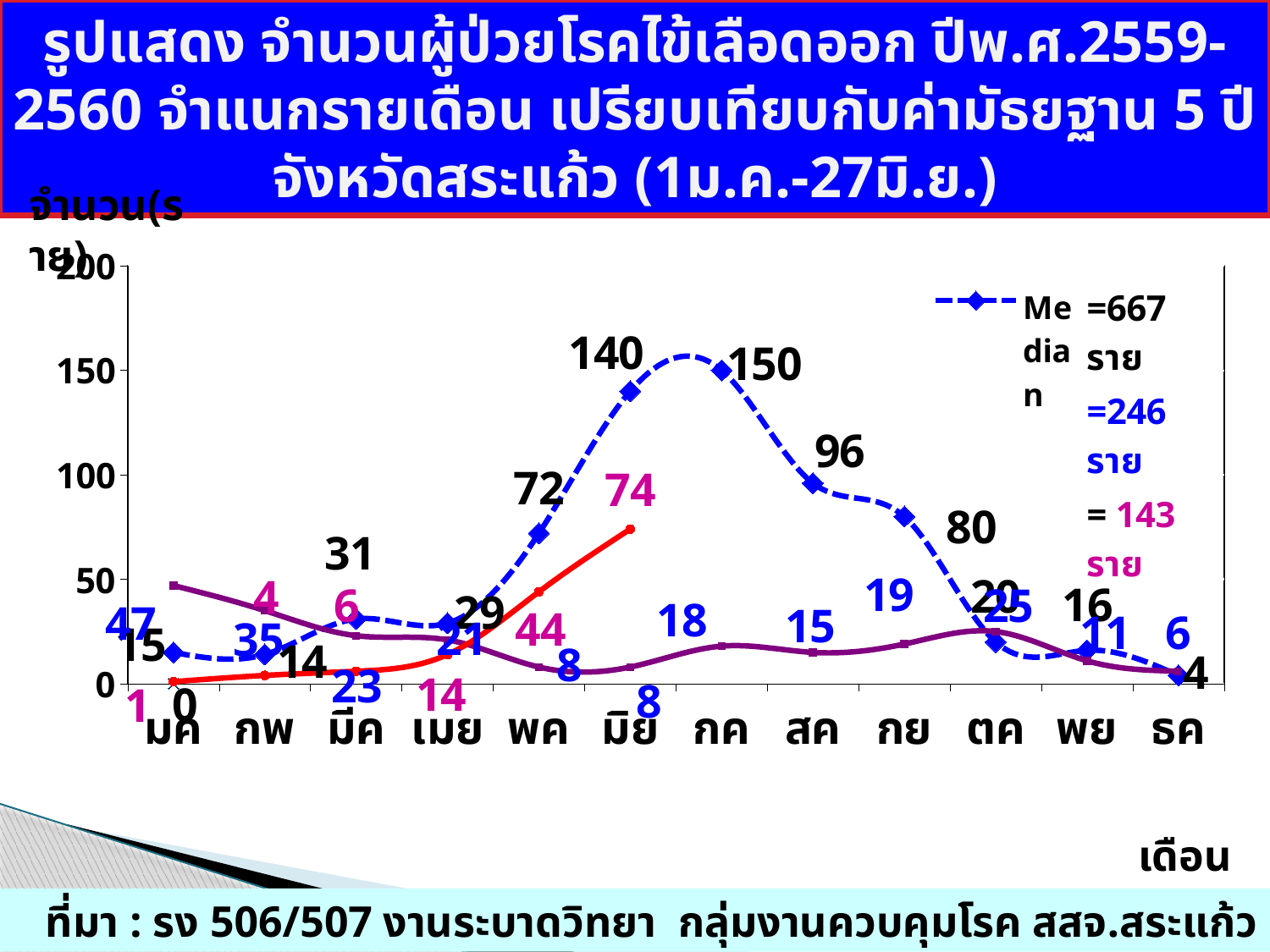
What total is shown in pink next to the legend? 143 ราย Does the red line rise or fall from มค to มิย? rises How many data points does the red line have? 6 What is the value of the purple line in มค? 47 What is the difference between the blue dashed line's values in กค and มิย? 10 In which month does the blue dashed line reach its highest value? กค What is the value of the blue dashed line in มิย? 140 What is the value of the red line in มิย? 74 In พค, which is larger: the blue dashed line or the red line? the blue dashed line What kind of chart is shown on the slide? line chart How many months are shown along the x axis? 12 In which month does the blue dashed line have its lowest value? ธค